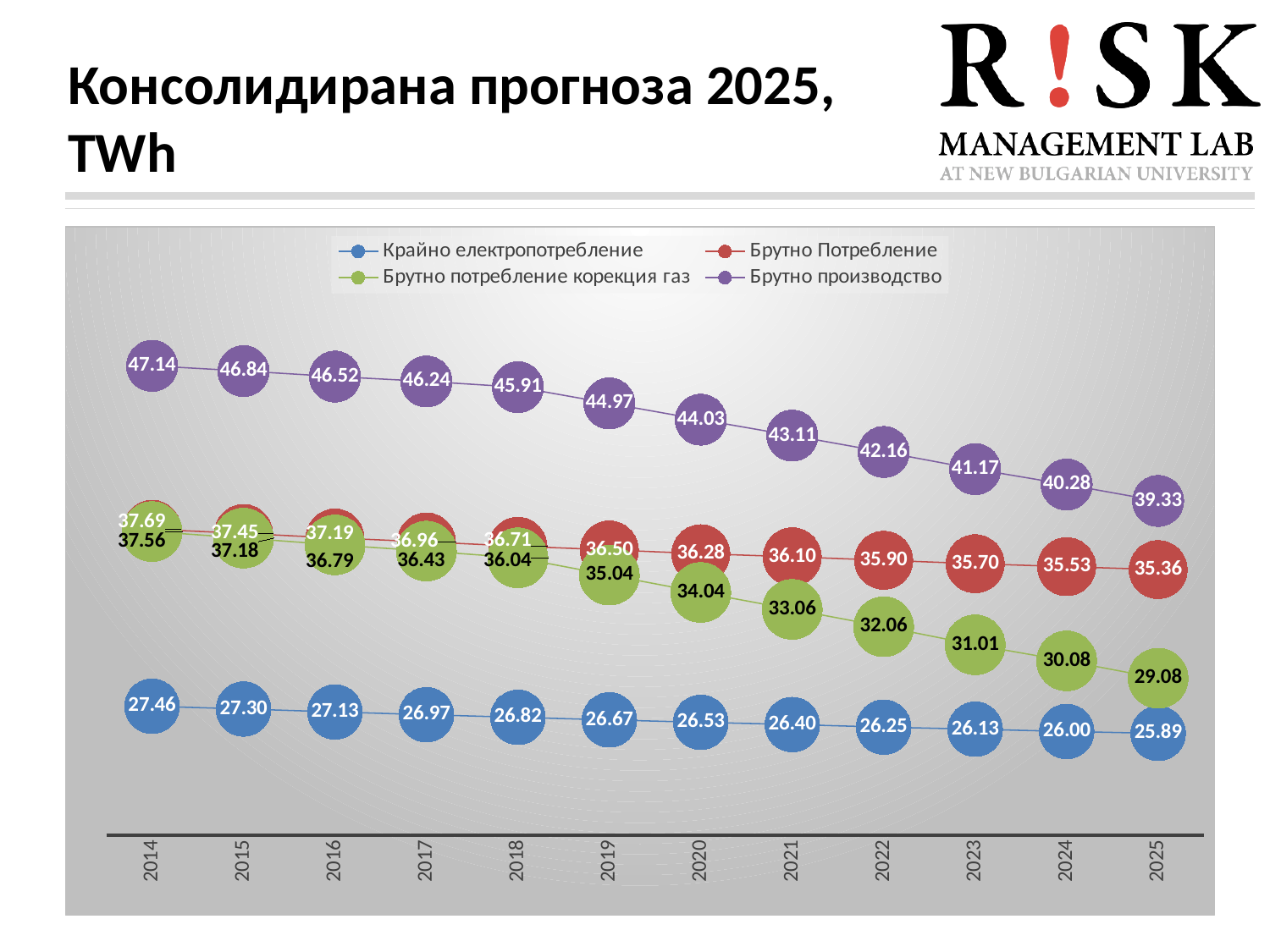
Which series has the highest values across all years? Брутно производство In which year is Брутно производство lowest? 2025 What is the value of Брутно производство in 2014? 47.14 What is the value of Брутно Потребление in 2019? 36.50 How many series does the legend list? 4 Do the values of Брутно потребление корекция газ rise or fall from 2014 to 2025? fall How many years are shown on the x axis? 12 What is the difference between Брутно Потребление and Брутно потребление корекция газ in 2025? 6.28 Which is larger in 2022: Брутно Потребление or Брутно потребление корекция газ? Брутно Потребление What type of chart is shown on the slide? line chart What is the value of Крайно електропотребление in 2025? 25.89 What is the value of Брутно потребление корекция газ in 2021? 33.06